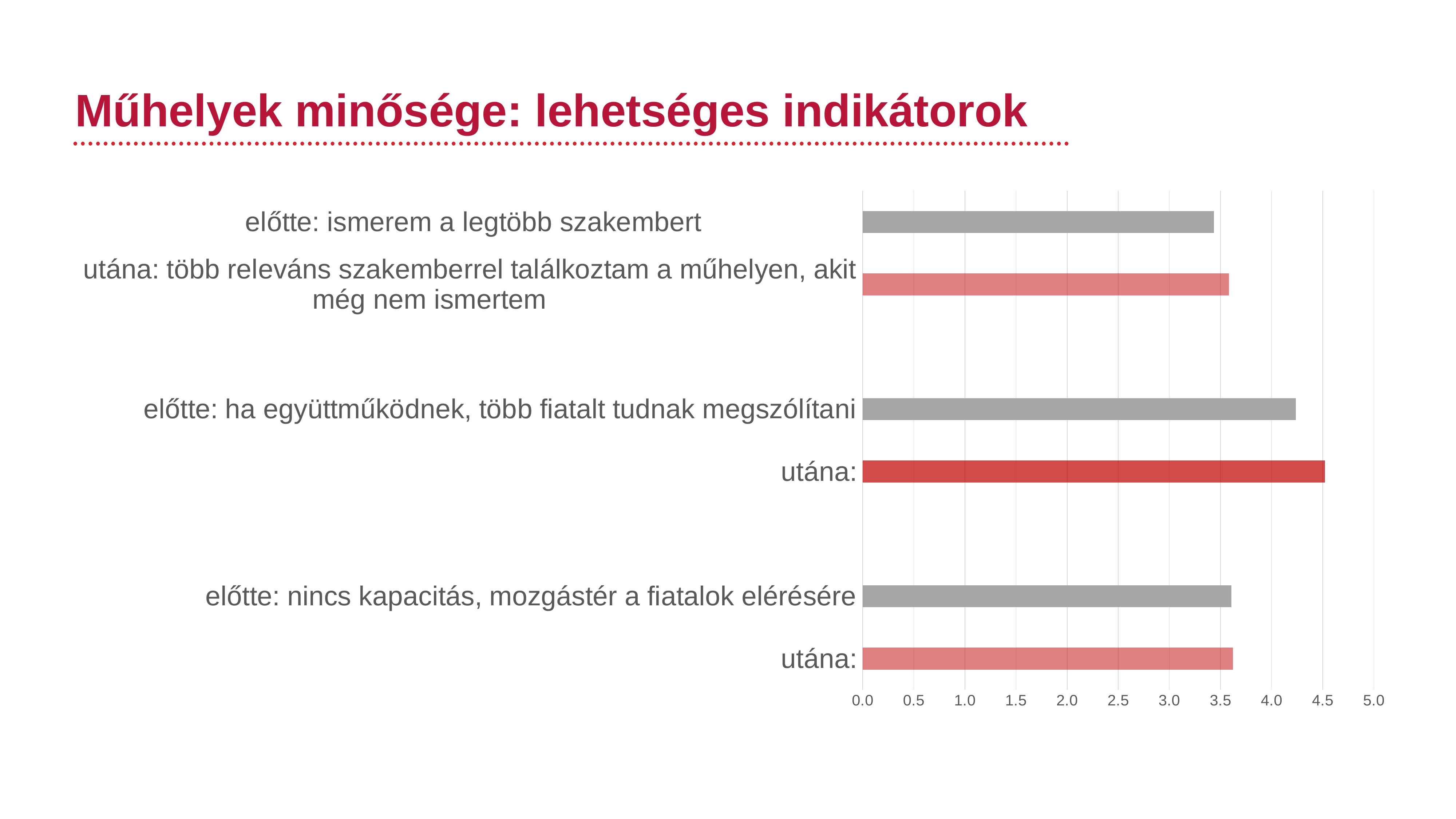
Is the value for "utána: több releváns szakemberrel találkoztam a műhelyen, akit még nem ismertem" greater or less than 4.0? less Is the value for the "utána:" bar directly below "előtte: ha együttműködnek, több fiatalt tudnak megszólítani" greater or less than 4.0? greater Which bar is the longest in the chart? utána: (below "előtte: ha együttműködnek, több fiatalt tudnak megszólítani") Is the value for "előtte: ha együttműködnek, több fiatalt tudnak megszólítani" greater or less than 4.0? greater What is the title of the slide containing the chart? Műhelyek minősége: lehetséges indikátorok Which is larger: the value for "előtte: ha együttműködnek, több fiatalt tudnak megszólítani" or the value for "előtte: ismerem a legtöbb szakembert"? előtte: ha együttműködnek, több fiatalt tudnak megszólítani What kind of chart is shown on the slide? bar chart What colour are the bars labelled "előtte" in the chart? grey How many bars are plotted in the chart? 6 Which is larger: the "utána:" bar below "előtte: ha együttműködnek, több fiatalt tudnak megszólítani" or the "utána:" bar at the bottom of the chart? the "utána:" bar below "előtte: ha együttműködnek, több fiatalt tudnak megszólítani"